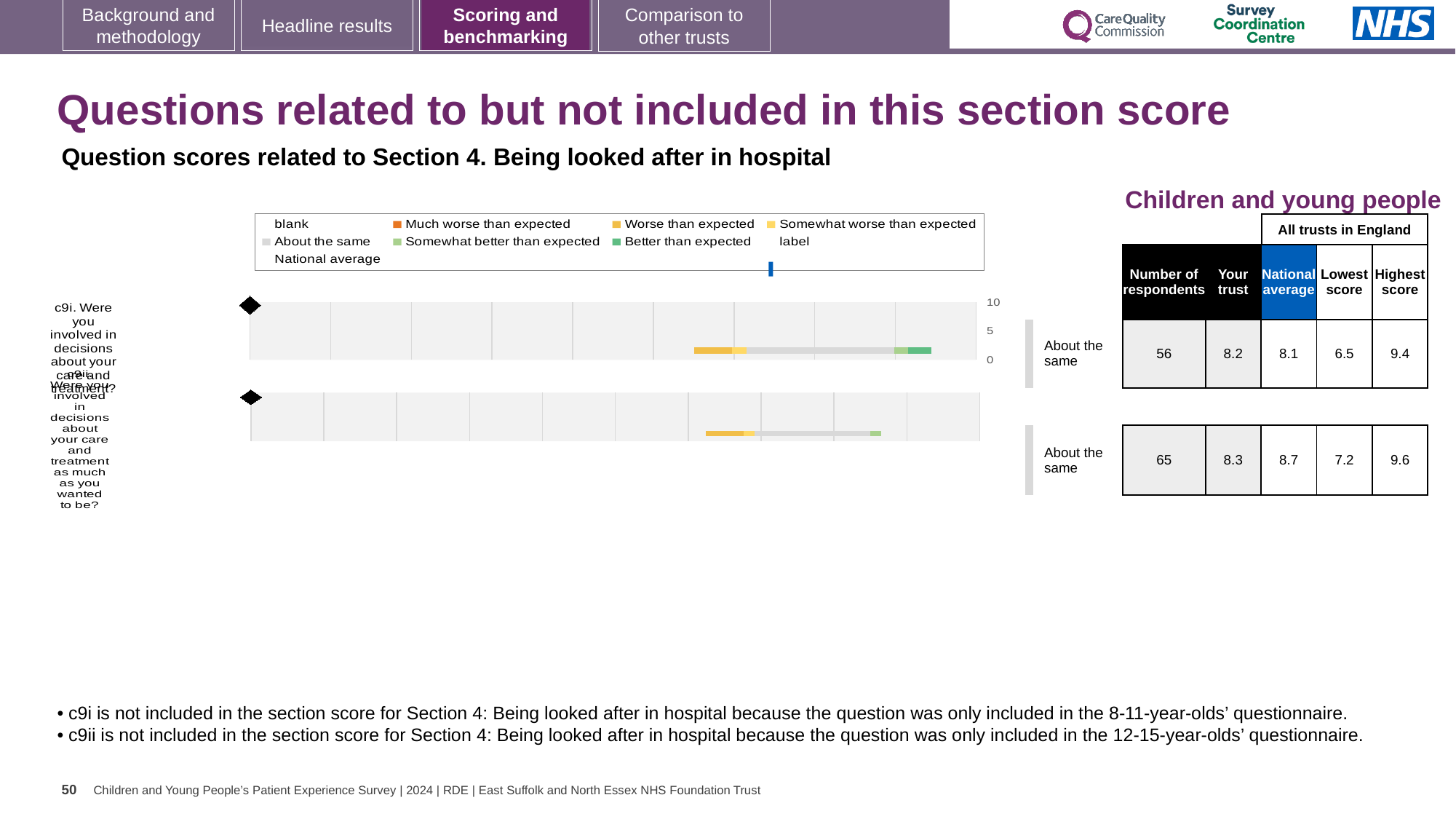
What is the 'Your trust' score for question c9ii? 8.3 What is the lowest score across all trusts in England for question c9i? 6.5 What is the national average score for question c9ii? 8.7 What is the highest tick value shown on the chart's score axis? 10 What is the national average score for question c9i? 8.1 What benchmark category is shown next to the chart for question c9i? About the same For question c9ii, how much higher is the national average than the 'Your trust' score? 0.4 What is the 'Your trust' score for question c9i? 8.2 How many respondents answered question c9i? 56 How many questions are plotted in the chart area? 2 What kind of chart is used to show the question scores for c9i and c9ii? Bar chart What is the highest score across all trusts in England for question c9ii? 9.6